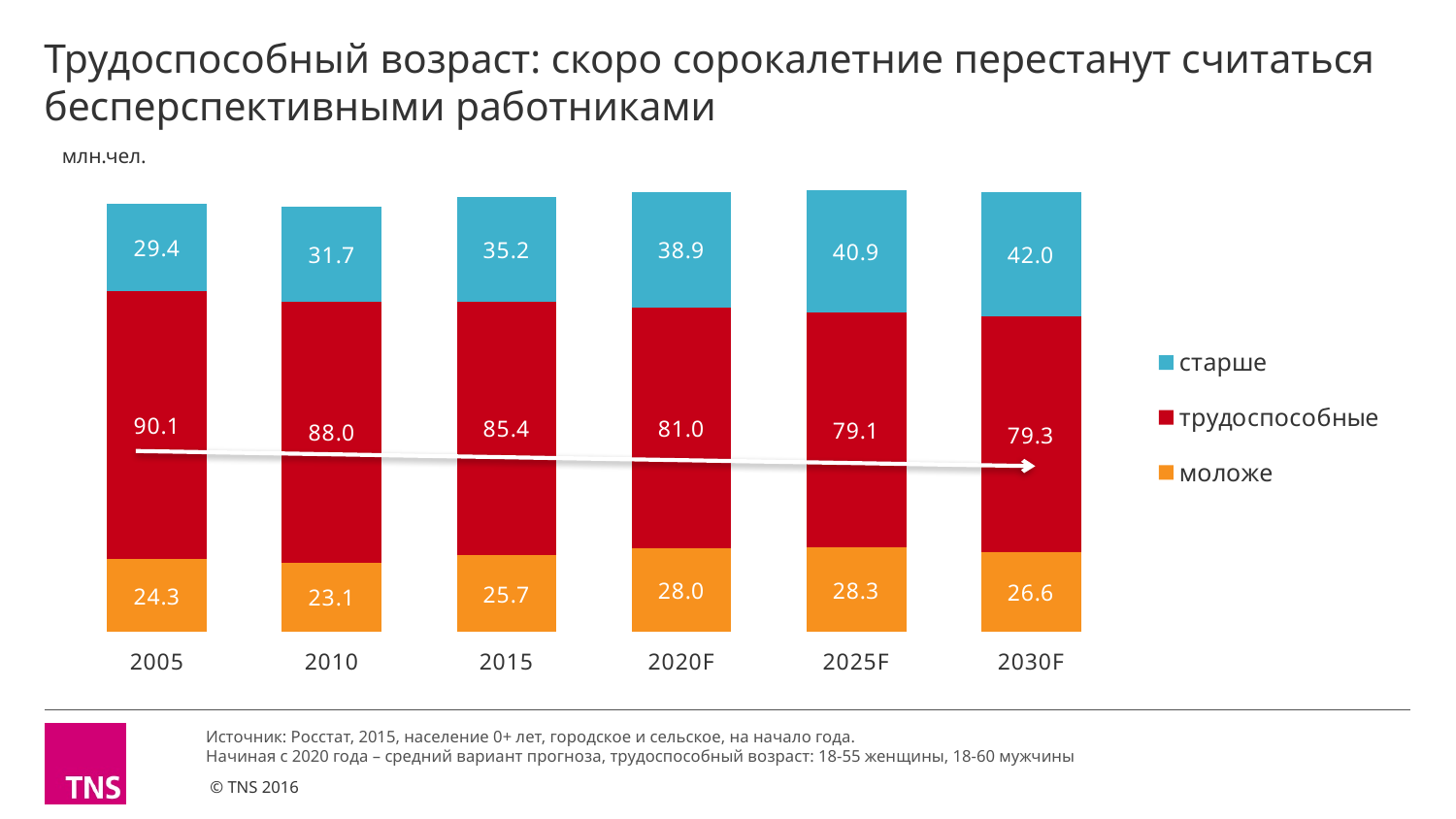
What is the difference between the трудоспособные values for 2005 and 2030F? 10.8 What is the value for моложе in 2020F? 28.0 What is the total of the stacked bar for 2010? 142.8 What kind of chart is shown on the slide? Stacked bar chart In which year is the value for трудоспособные the highest? 2005 What is the value for старше in 2030F? 42.0 In which year is the value for моложе the lowest? 2010 Does the value for старше rise or fall from 2005 to 2030F? Rises Which is larger: the старше value in 2015 or the моложе value in 2015? старше (35.2) How many series does the legend list? 3 How many years are shown on the x axis? 6 What is the value for трудоспособные in 2005? 90.1